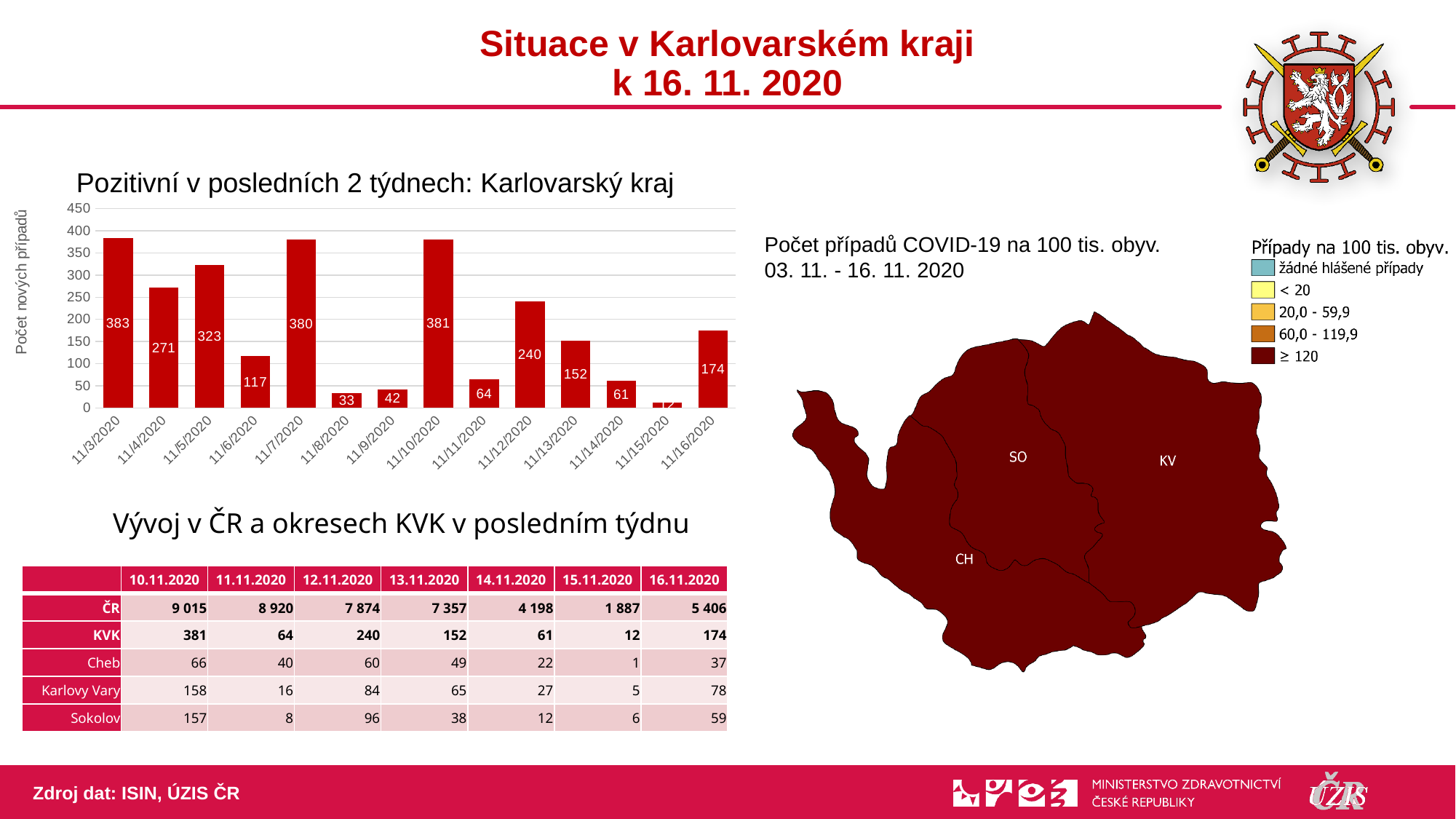
In the bar chart, what is the value for 11/3/2020? 383 In the bar chart, what is the value for 11/12/2020? 240 Which date has the highest value in the bar chart? 11/3/2020 In the bar chart, which is larger: the value for 11/4/2020 or 11/5/2020? 11/5/2020 What is the y-axis title of the bar chart? Počet nových případů What kind of chart is 'Pozitivní v posledních 2 týdnech: Karlovarský kraj'? bar chart In the bar chart, what is the value for 11/8/2020? 33 In the bar chart, what is the difference between the values for 11/13/2020 and 11/14/2020? 91 How many dates are shown on the x axis of the bar chart 'Pozitivní v posledních 2 týdnech: Karlovarský kraj'? 14 In the bar chart, is the value for 11/16/2020 greater or less than 150? greater Which date has the lowest value in the bar chart? 11/15/2020 In the bar chart, what is the difference between the values for 11/10/2020 and 11/11/2020? 317